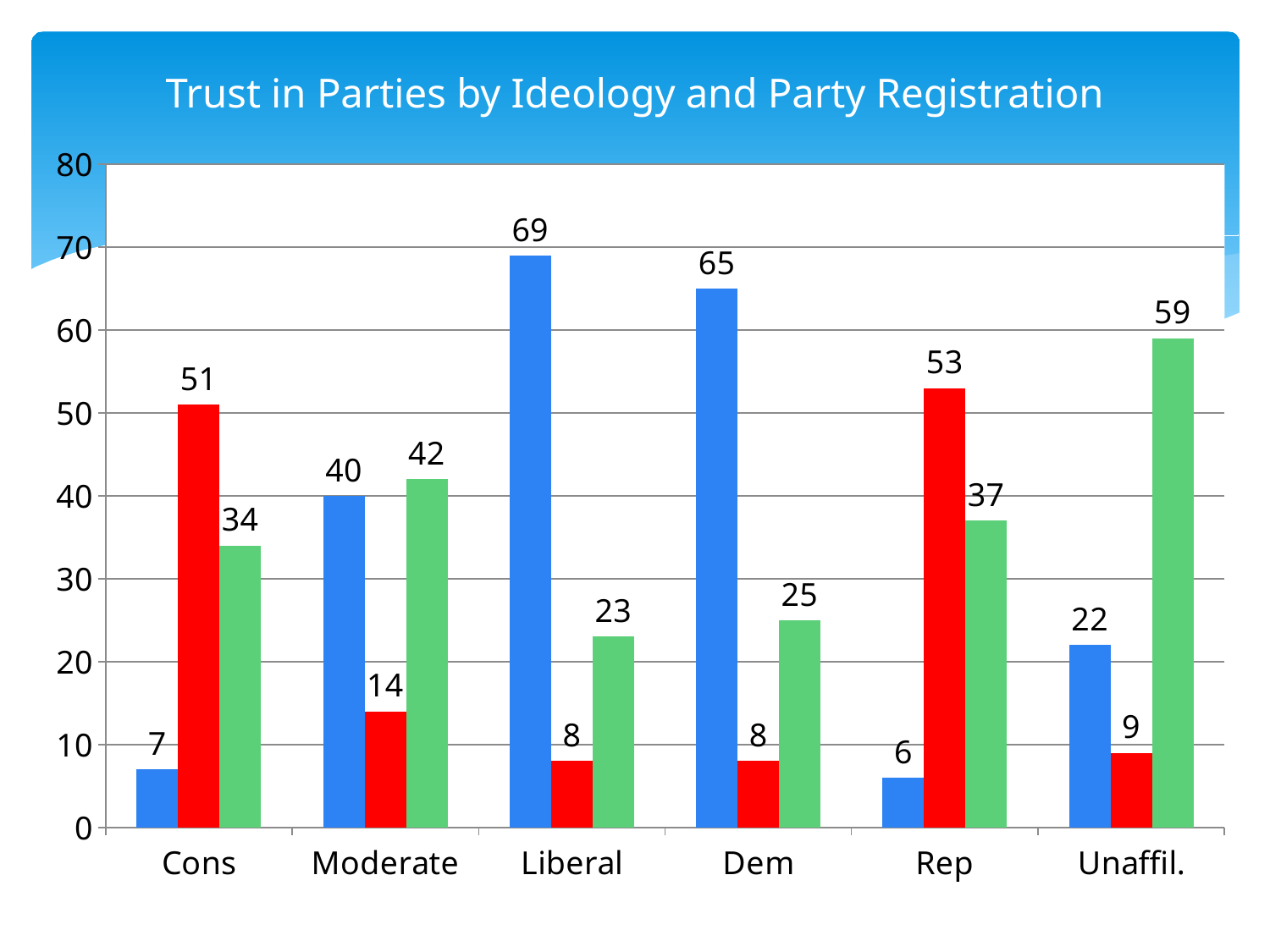
Which category has the highest green bar? Unaffil. What is the difference between the blue bar and the red bar for Dem? 57 Which is larger for Cons, the red bar or the green bar? the red bar What is the value of the red bar for Rep? 53 What is the title of the chart? Trust in Parties by Ideology and Party Registration What is the value of the red bar for Moderate? 14 How many categories are shown on the x axis? 6 What kind of chart is shown on the slide? bar chart Which category has the lowest blue bar? Rep Which category has the highest blue bar? Liberal What is the value of the blue bar for Liberal? 69 What is the value of the green bar for Unaffil.? 59